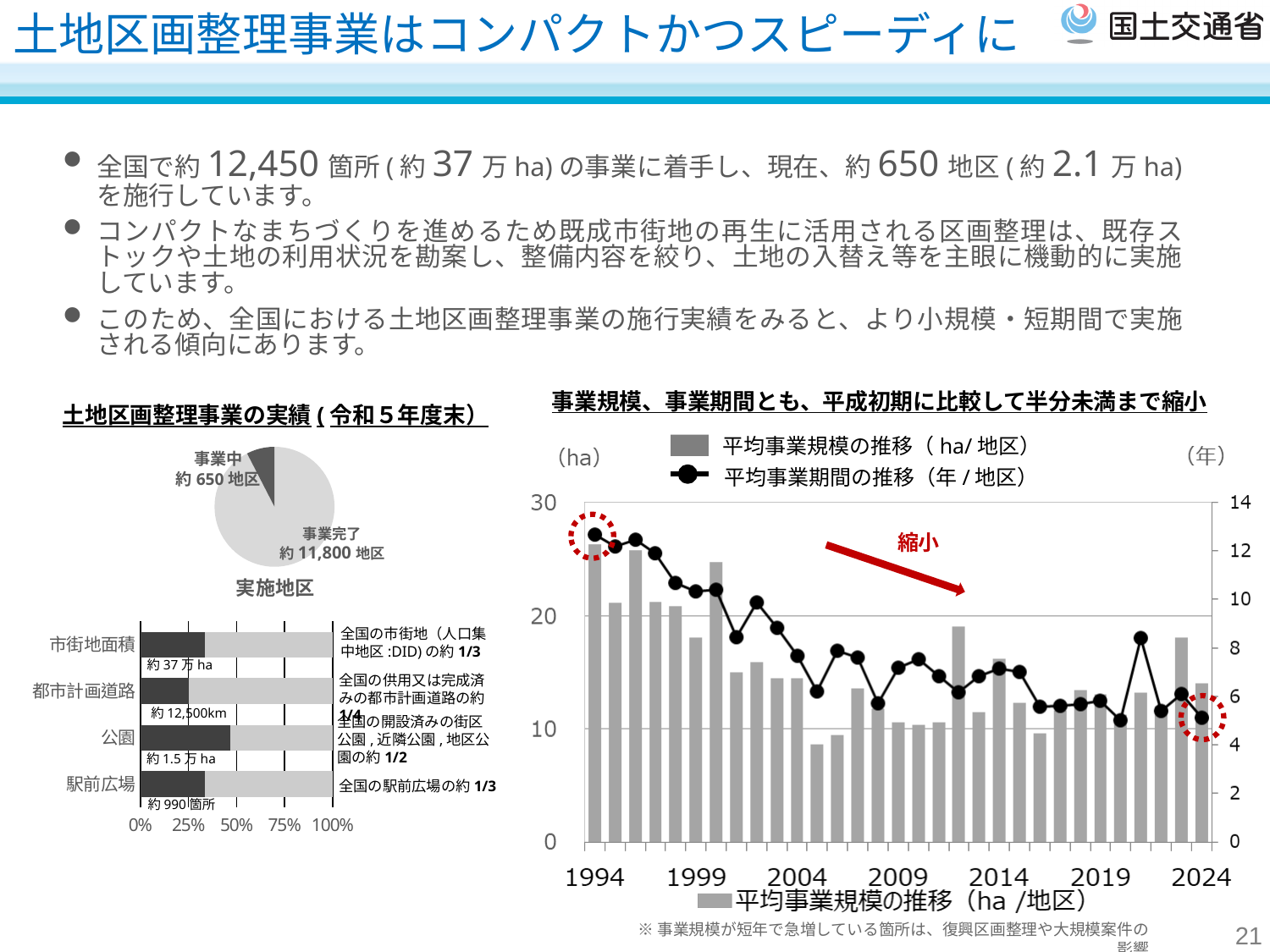
In the chart on the right (平均事業規模の推移 / 平均事業期間の推移), how many series does the legend list? 2 In the chart on the right, what kind of chart is used to show 平均事業規模の推移? bar chart In the horizontal bar chart on the lower left, is the dark bar for 公園 greater or less than 25%? greater In the pie chart labelled 実施地区, what is the value shown for 事業中? 約650地区 In the pie chart labelled 実施地区, which slice is larger, 事業中 or 事業完了? 事業完了 In the chart on the right, do the bars for 平均事業規模の推移 generally rise or fall from 1994 to 2024? fall In the pie chart labelled 実施地区, what is the value shown for 事業完了? 約11,800地区 In the horizontal bar chart on the lower left, is the dark bar for 都市計画道路 greater or less than 50%? less In the horizontal bar chart on the lower left, how many categories are shown? 4 In the horizontal bar chart on the lower left, what value label is printed for 都市計画道路? 約12,500km In the chart on the right, is the bar for 1994 greater or less than 20 ha? greater In the horizontal bar chart on the lower left, which category has the longest dark bar? 公園